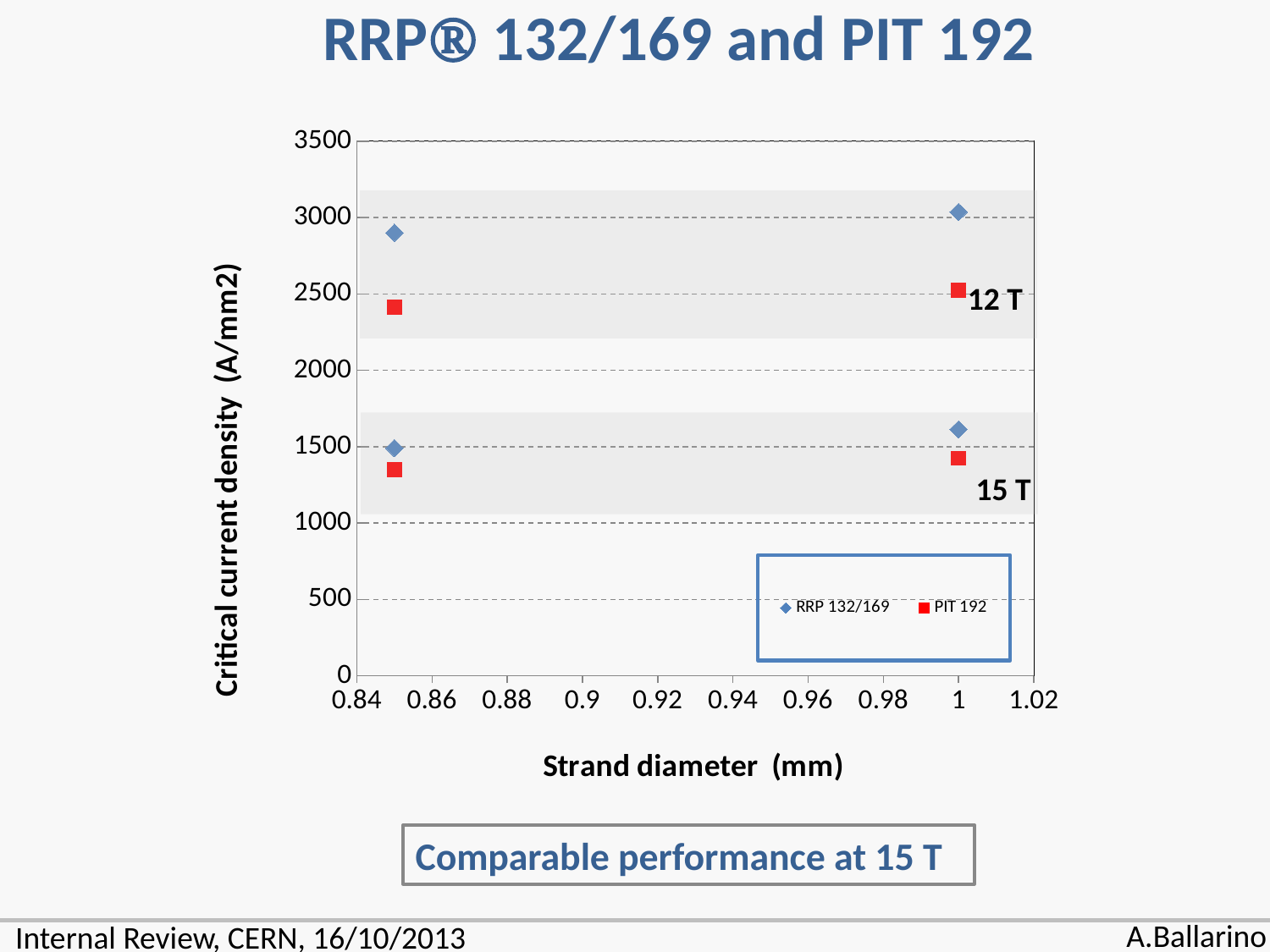
At 0.85 mm in the 12 T band, which series has the higher critical current density, RRP 132/169 or PIT 192? RRP 132/169 Which series has the highest plotted point on the chart? RRP 132/169 Is the RRP 132/169 value at 1 mm in the 15 T band greater or less than 1500? greater What are the two series named in the legend? RRP 132/169 and PIT 192 What is the y-axis title of the chart? Critical current density (A/mm2) Is the PIT 192 value at 0.85 mm in the 15 T band greater or less than 1500? less How many data points are plotted for the RRP 132/169 series? 4 What kind of chart is shown on the slide? Scatter chart Is the PIT 192 value at 0.85 mm in the 12 T band greater or less than 2500? less How many series does the legend list? 2 For the RRP 132/169 series in the 12 T band, does the critical current density rise or fall as strand diameter increases from 0.85 mm to 1 mm? rise